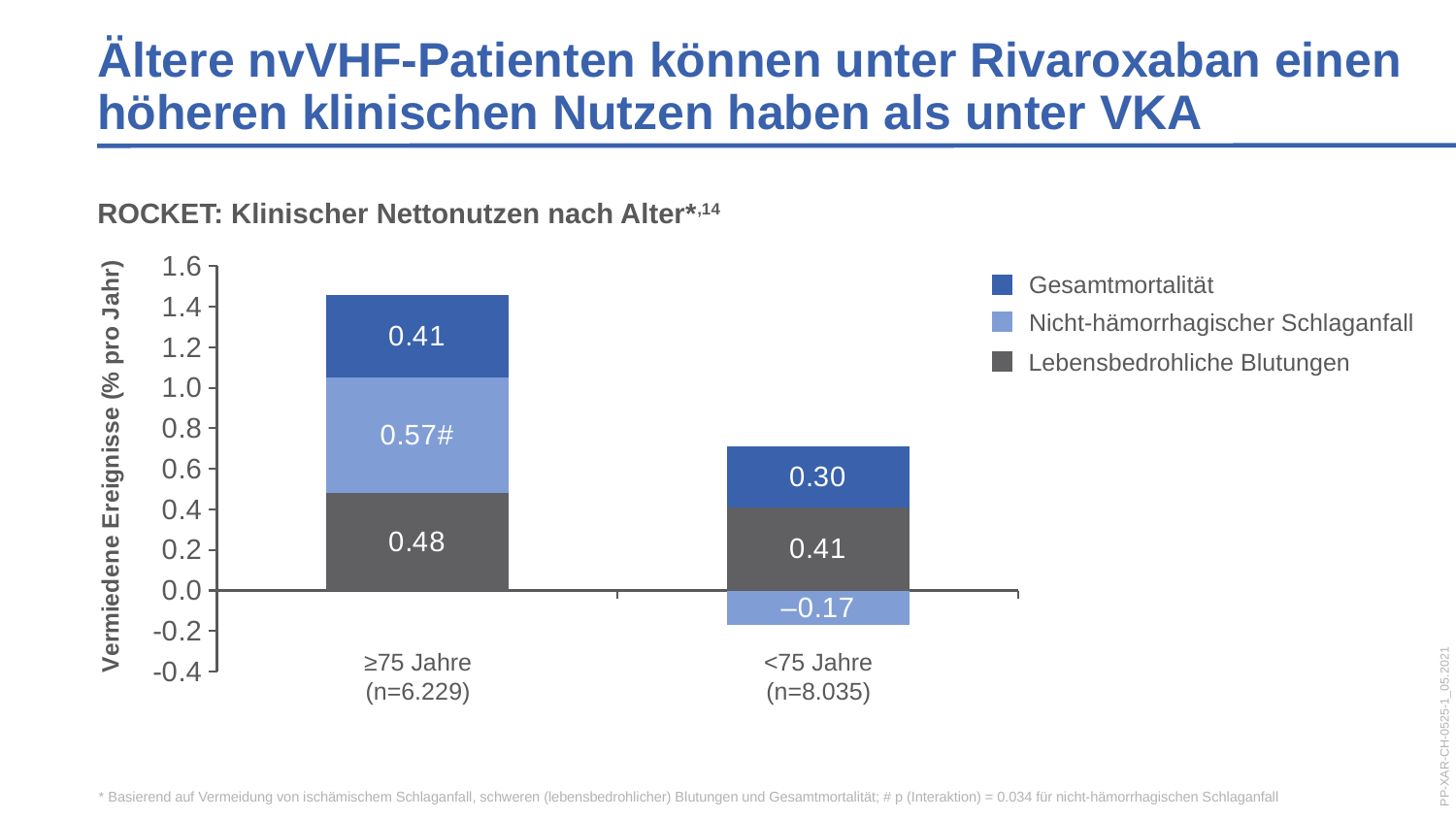
What kind of chart is shown? Stacked bar chart Is the top of the stacked bar for the <75 Jahre group greater or less than 1.0? less What is the value of Lebensbedrohliche Blutungen for the <75 Jahre group? 0.41 What is the value of Lebensbedrohliche Blutungen for the ≥75 Jahre group? 0.48 What is the value of Nicht-hämorrhagischer Schlaganfall for the <75 Jahre group? –0.17 Is Lebensbedrohliche Blutungen larger for the ≥75 Jahre group or the <75 Jahre group? ≥75 Jahre How many series does the legend list? 3 How many age groups are shown on the x axis? 2 What is the difference in Gesamtmortalität between the ≥75 Jahre and <75 Jahre groups? 0.11 Which age group has the taller stacked bar? ≥75 Jahre What is the value of Gesamtmortalität for the ≥75 Jahre group? 0.41 What is the total of the stacked bar for the ≥75 Jahre group? 1.46